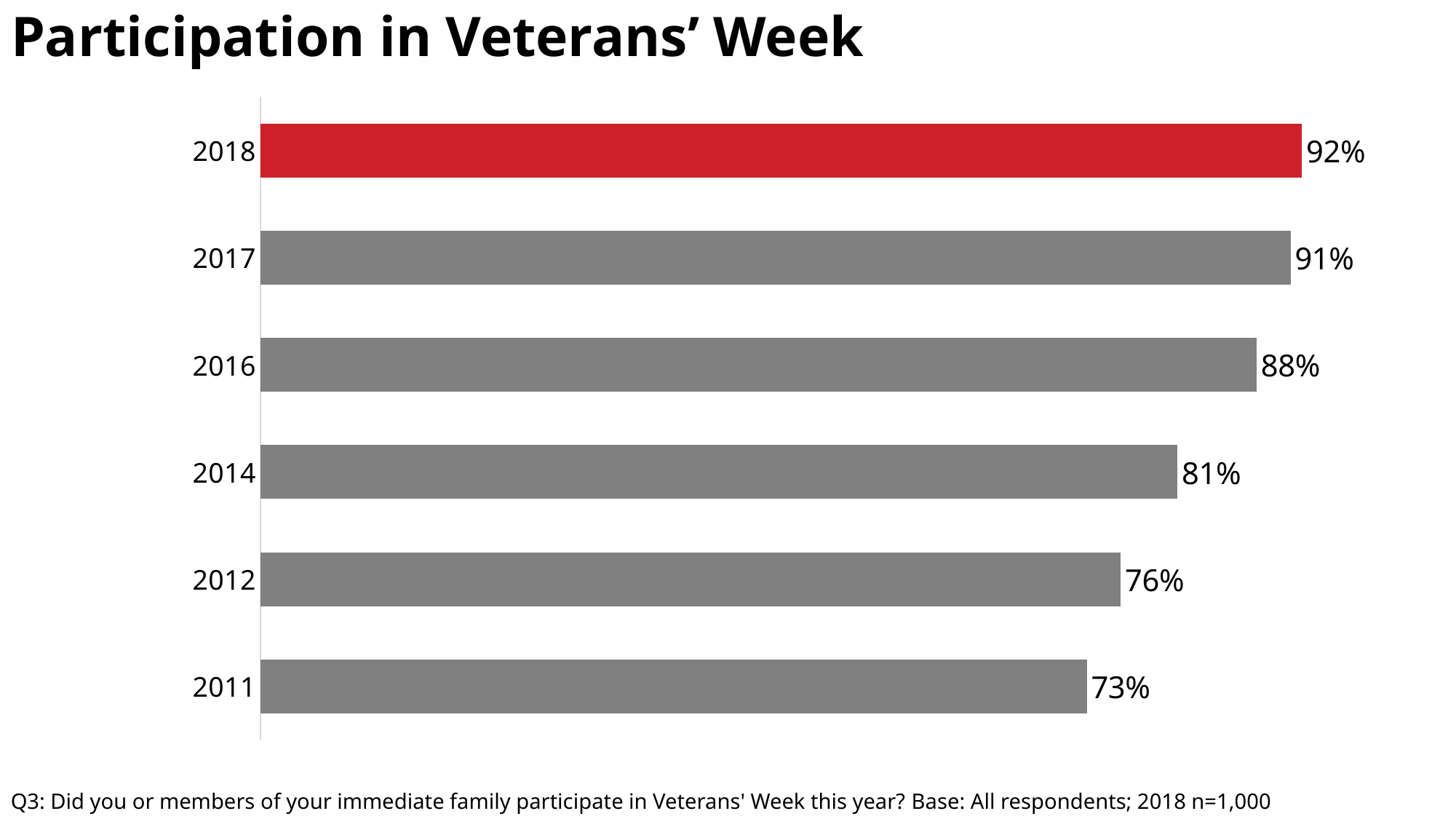
What is the difference between the 2018 and 2011 participation values? 19% Which year's bar is coloured red? 2018 What kind of chart is shown on the slide? Bar chart What is the participation value for 2018? 92% Which year has the lowest participation value? 2011 Which is larger, the value for 2012 or the value for 2016? 2016 What is the participation value for 2014? 81% What is the participation value for 2011? 73% Which year has the highest participation value? 2018 What is the difference between the 2016 and 2014 participation values? 7% How many years are shown in the chart? 6 Do the participation values rise or fall from 2011 to 2018? Rise